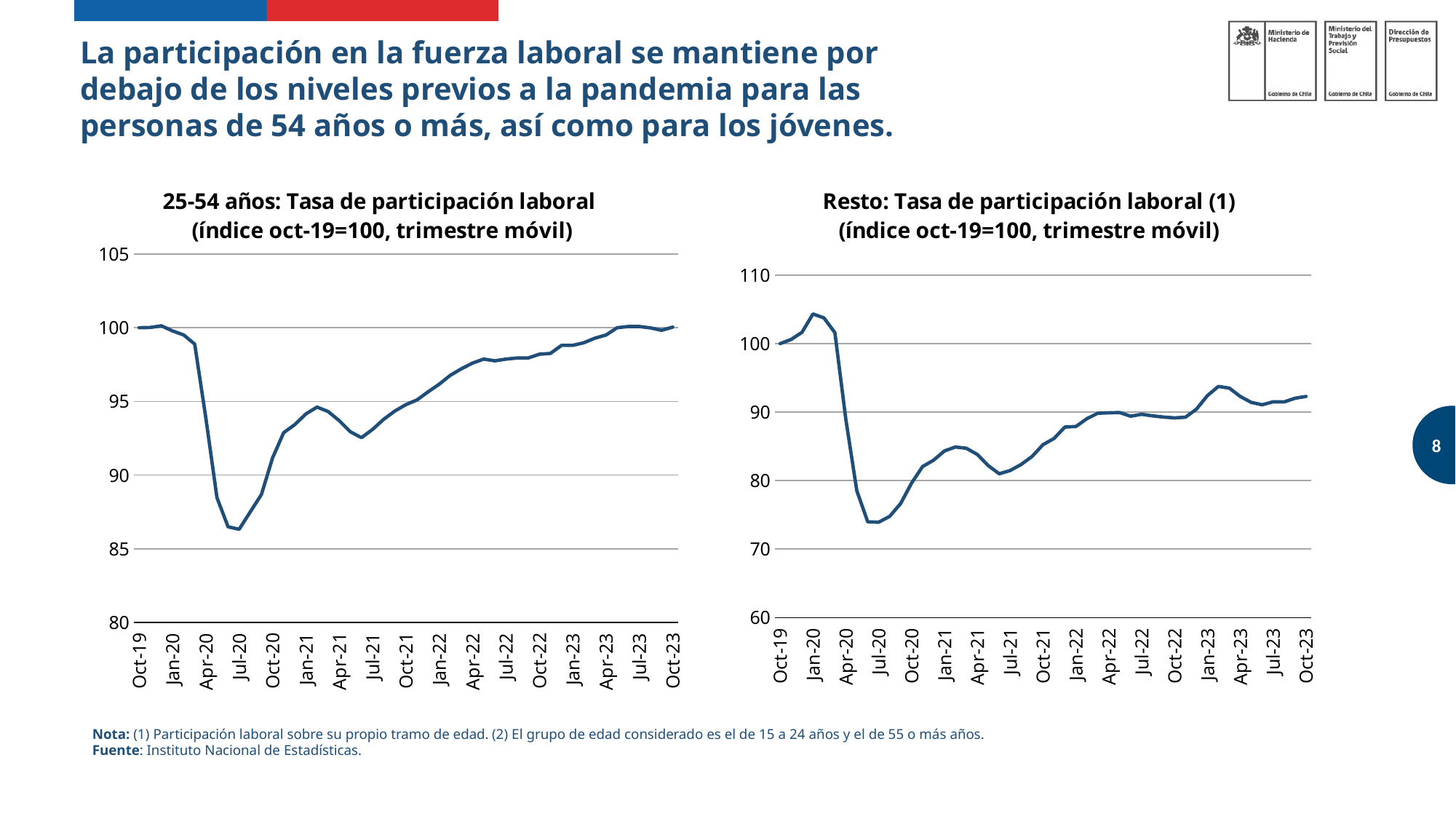
In the left chart (25-54 años), is the value for Oct-23 greater or less than 95? greater What is the first x-axis label on the right chart (Resto)? Oct-19 In the right chart (Resto), is the value for Jul-20 greater or less than 80? less What kind of chart is the left chart titled '25-54 años: Tasa de participación laboral'? Line chart In the right chart (Resto), which is larger, the value for Jan-20 or the value for Oct-23? Jan-20 In the right chart (Resto), is the value for Oct-23 greater or less than 100? less In the left chart (25-54 años), do the values rise or fall between Jul-20 and Oct-23? Rise How many charts are shown on the slide? 2 In the left chart (25-54 años), what is the index value for Oct-19? 100 In the right chart (Resto), what is the index value for Oct-19? 100